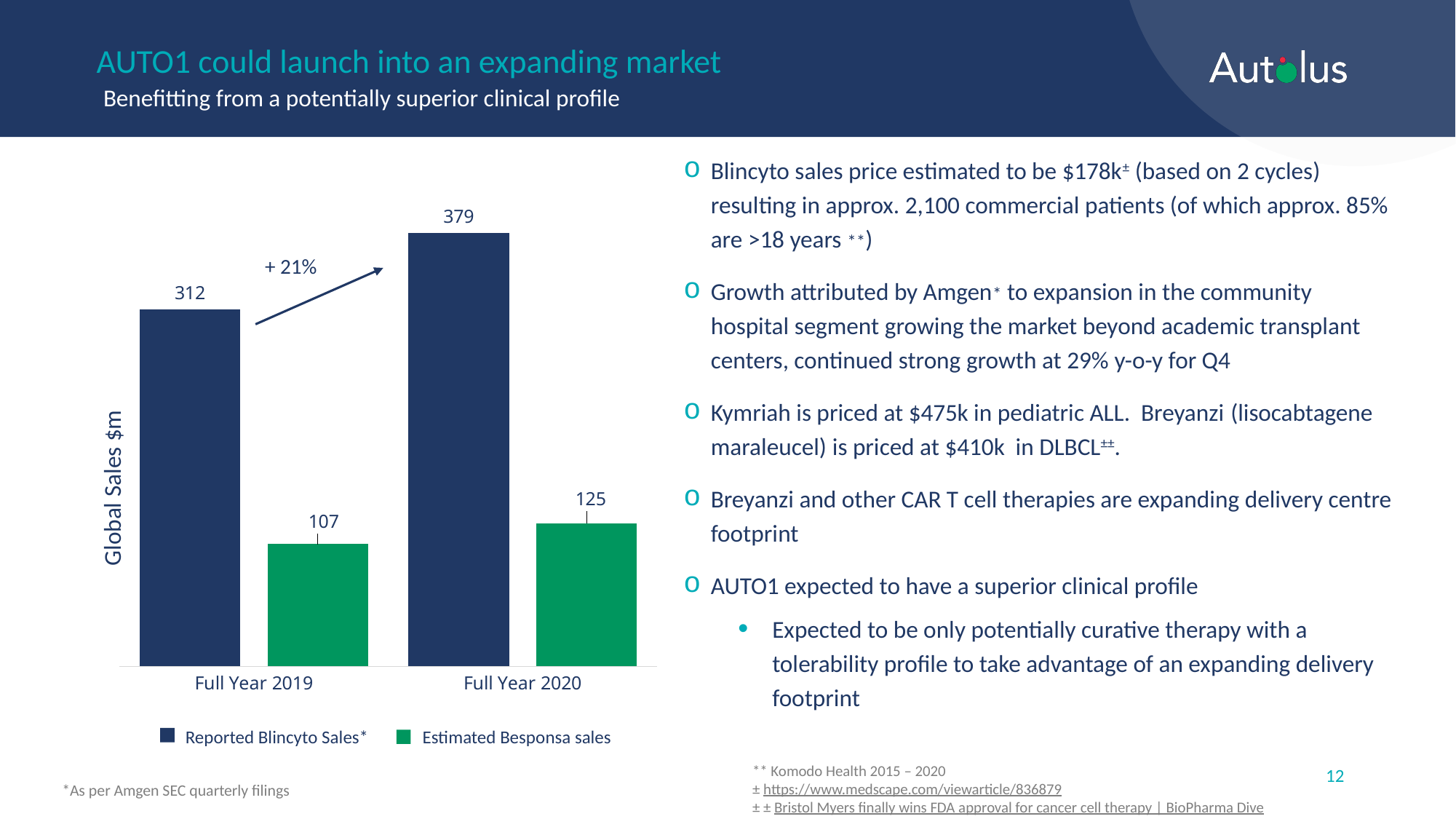
What is the difference between Reported Blincyto Sales in Full Year 2020 and Full Year 2019? 67 What were the Reported Blincyto Sales in Full Year 2019? 312 Which is larger: Estimated Besponsa sales in Full Year 2020 or Reported Blincyto Sales in Full Year 2019? Reported Blincyto Sales in Full Year 2019 What were the Estimated Besponsa sales in Full Year 2020? 125 What were the Estimated Besponsa sales in Full Year 2019? 107 What were the Reported Blincyto Sales in Full Year 2020? 379 What is the y-axis label of the chart? Global Sales $m Do Reported Blincyto Sales rise or fall from Full Year 2019 to Full Year 2020? Rise Which bar in the chart has the lowest value? Estimated Besponsa sales, Full Year 2019 How many series does the chart legend list? 2 Which bar in the chart has the highest value? Reported Blincyto Sales, Full Year 2020 What kind of chart is shown on the slide? Bar chart